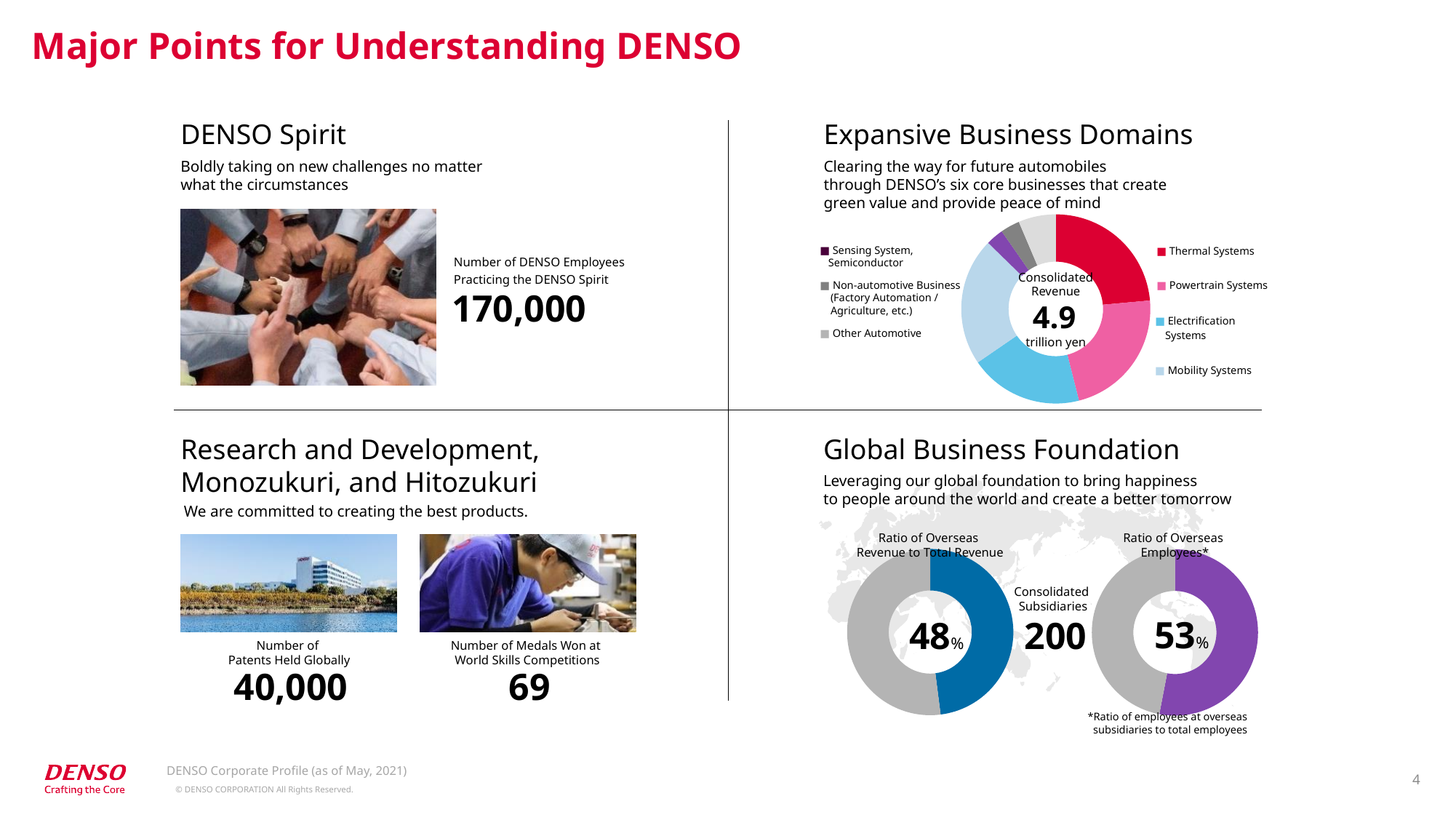
What is the difference between the Ratio of Overseas Employees and the Ratio of Overseas Revenue to Total Revenue? 5% In the Consolidated Revenue donut chart, which is larger: Thermal Systems or Mobility Systems? Thermal Systems In the Global Business Foundation section, what is the Ratio of Overseas Revenue to Total Revenue? 48% In the Consolidated Revenue donut chart, which is larger: Electrification Systems or Other Automotive? Electrification Systems Which is larger: the Ratio of Overseas Revenue to Total Revenue or the Ratio of Overseas Employees? Ratio of Overseas Employees In the Consolidated Revenue donut chart, what colour represents Powertrain Systems? Pink In the Consolidated Revenue donut chart, which segment has the largest share? Thermal Systems How many business segments does the legend of the Consolidated Revenue donut chart list? 7 What kind of chart is the Consolidated Revenue chart under Expansive Business Domains? Donut (pie) chart What consolidated revenue figure is shown in the center of the Expansive Business Domains donut chart? 4.9 trillion yen In the Global Business Foundation section, what is the Ratio of Overseas Employees? 53%